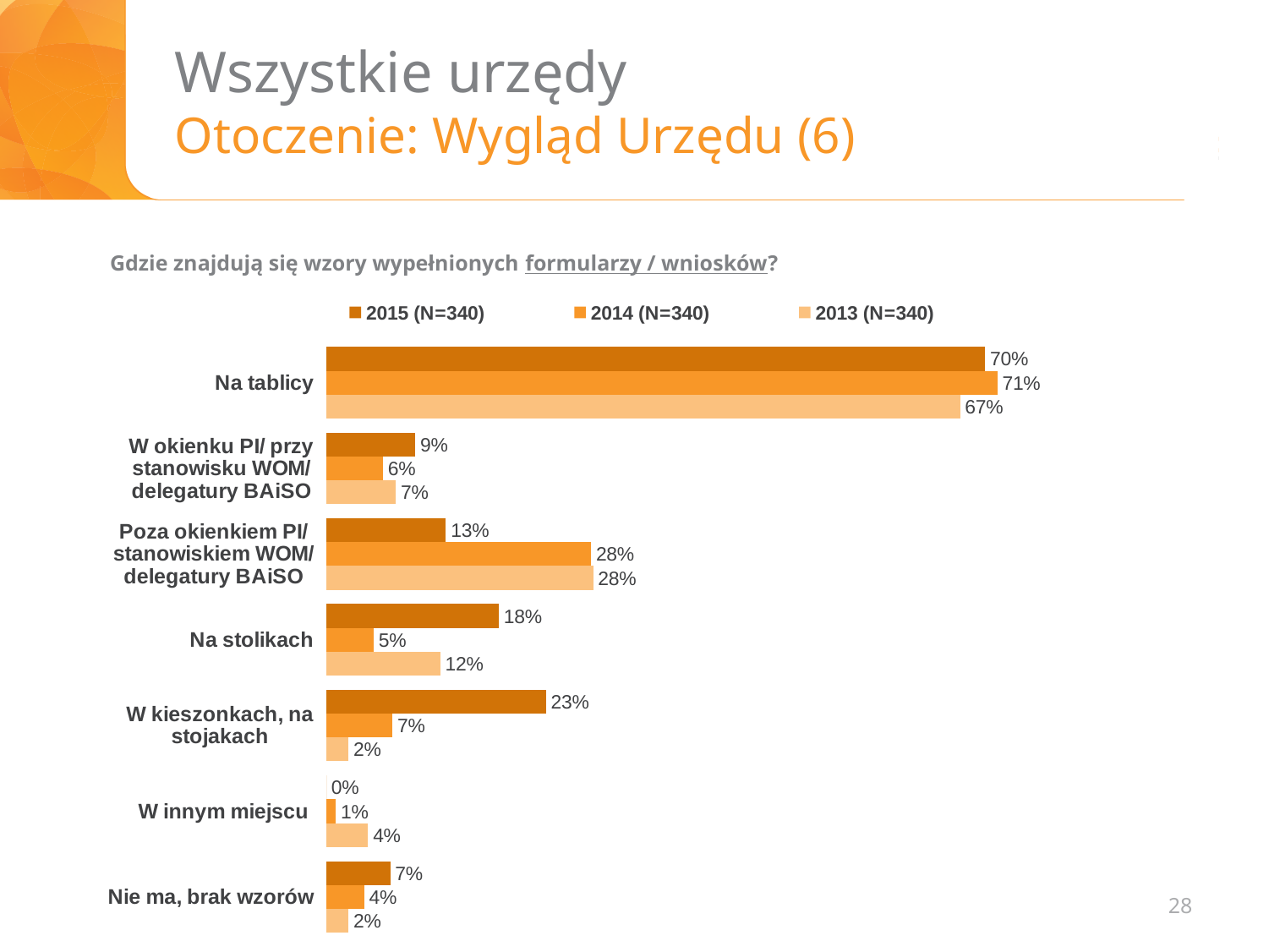
What is the value for "Na tablicy" in the 2015 (N=340) series? 70% What is the difference between the 2015 and 2014 values for "W kieszonkach, na stojakach"? 16 percentage points Which category has the lowest value in the 2015 (N=340) series? W innym miejscu What is the difference between the 2014 and 2013 values for "Na tablicy"? 4 percentage points What question does the chart answer, according to the text above it? Gdzie znajdują się wzory wypełnionych formularzy / wniosków? How many series does the legend list? 3 Which category has the highest value in the 2015 (N=340) series? Na tablicy What kind of chart is shown on the slide? Bar chart How many categories are shown on the chart? 7 What is the value for "W kieszonkach, na stojakach" in the 2013 (N=340) series? 2% Which is larger for "Poza okienkiem PI/ stanowiskiem WOM/ delegatury BAiSO": the 2015 value or the 2014 value? 2014 What is the value for "Na stolikach" in the 2014 (N=340) series? 5%